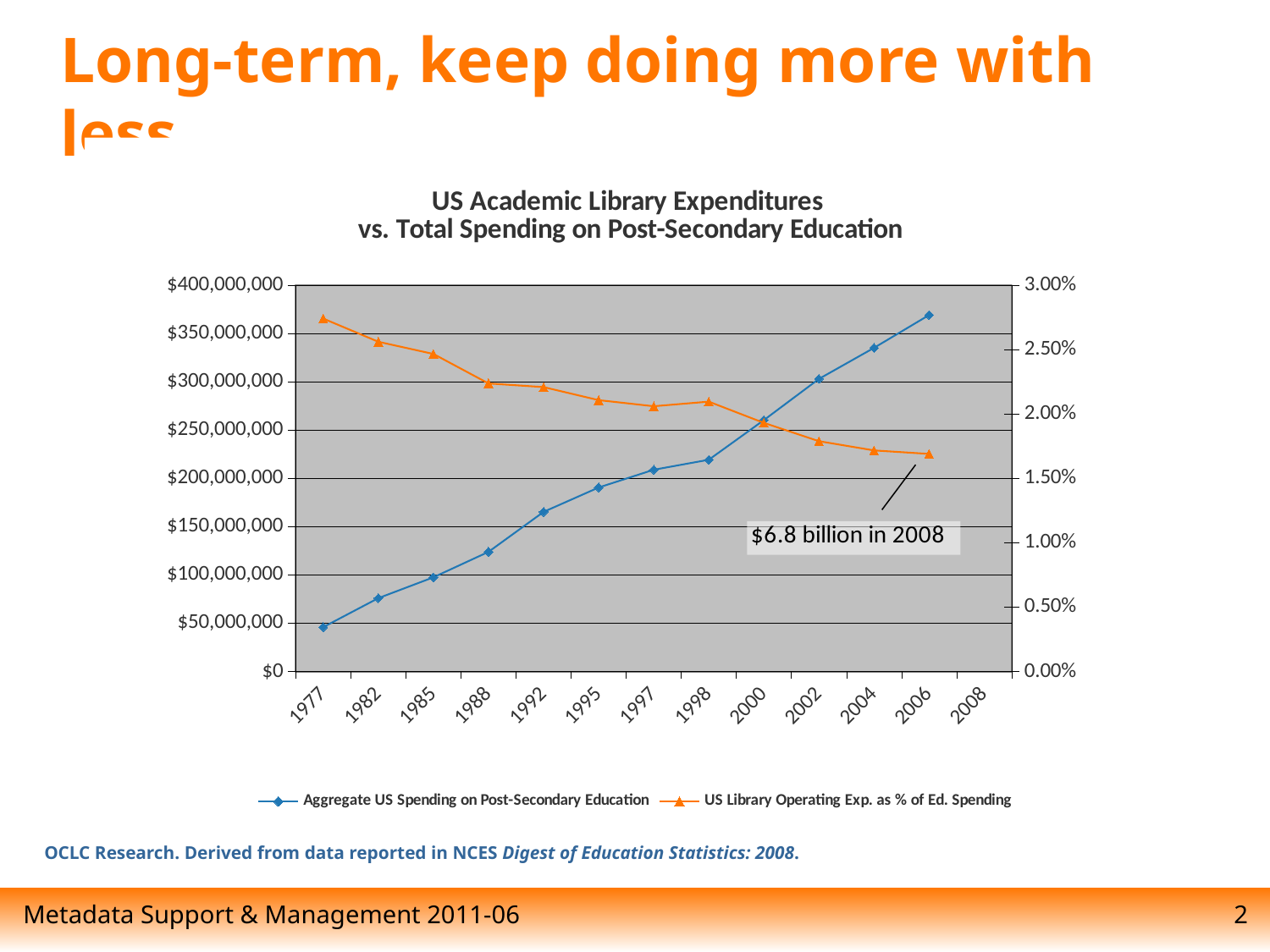
Does the US Library Operating Exp. as % of Ed. Spending series rise or fall from 1977 to 2006? fall In which year is the US Library Operating Exp. as % of Ed. Spending series at its highest? 1977 In which year is the Aggregate US Spending on Post-Secondary Education series at its highest? 2006 How many series does the legend list? 2 Does the Aggregate US Spending on Post-Secondary Education series rise or fall from 1977 to 2006? rise In which year is the US Library Operating Exp. as % of Ed. Spending series at its lowest? 2006 Is the Aggregate US Spending on Post-Secondary Education value for 2006 greater or less than $350,000,000? greater What kind of chart is shown on the slide? line chart How many year labels are shown along the x axis? 13 What value does the annotation on the chart give for 2008? $6.8 billion in 2008 Is the US Library Operating Exp. as % of Ed. Spending value for 2006 greater or less than 2.00%? less